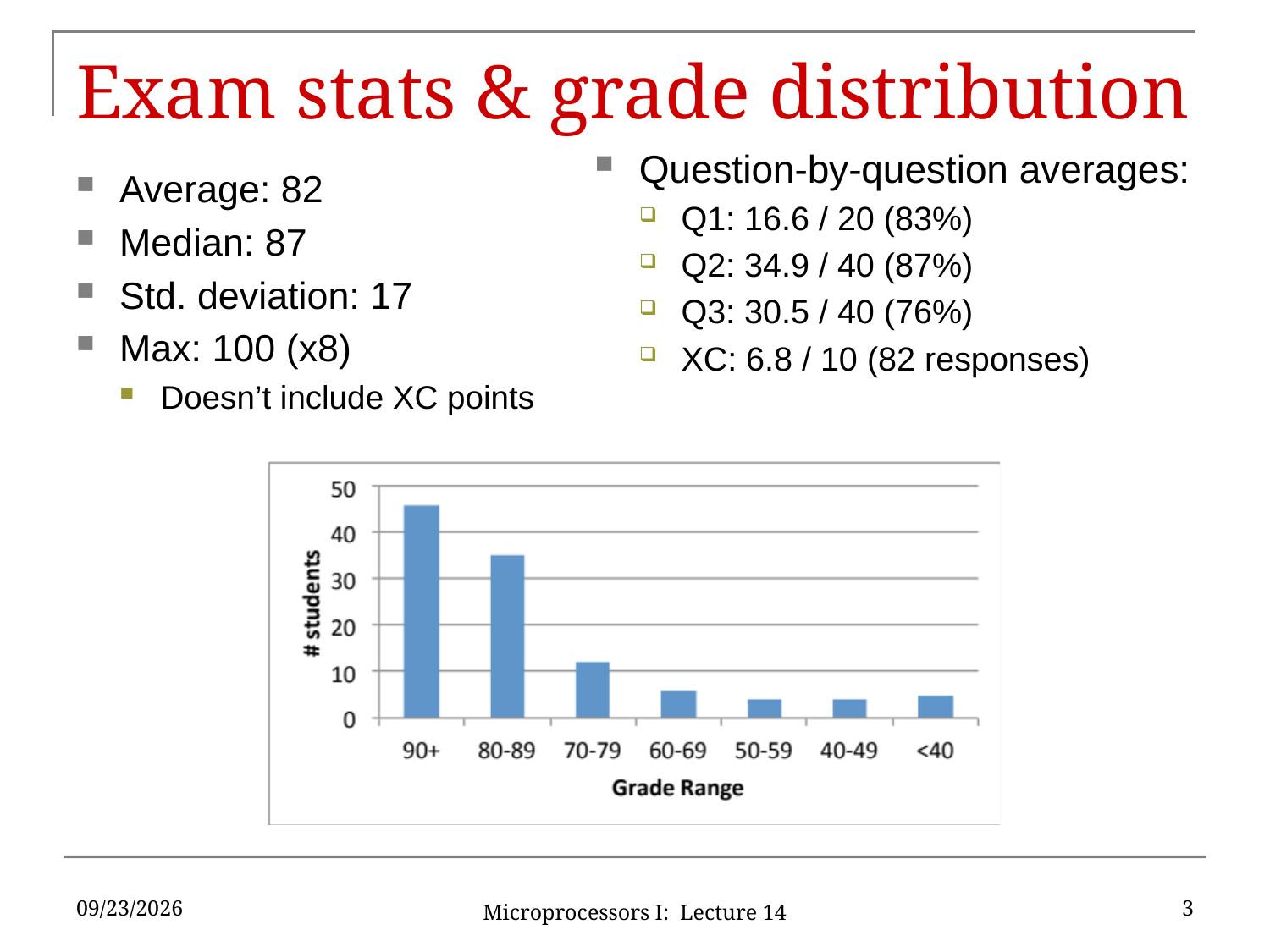
Is the number of students in the 60-69 grade range greater or less than 10? less How many grade range categories are shown on the x axis of the chart? 7 Is the number of students in the 80-89 grade range greater or less than 30? greater Is the number of students in the <40 grade range greater or less than 10? less Which has more students, the 70-79 range or the 60-69 range? 70-79 Do the bar heights generally rise or fall moving from 90+ to <40 along the x axis? fall What kind of chart is shown on the slide? bar chart What is the label of the chart's vertical axis? # students Which grade range has the highest number of students in the chart? 90+ Which has more students, the 90+ range or the 80-89 range? 90+